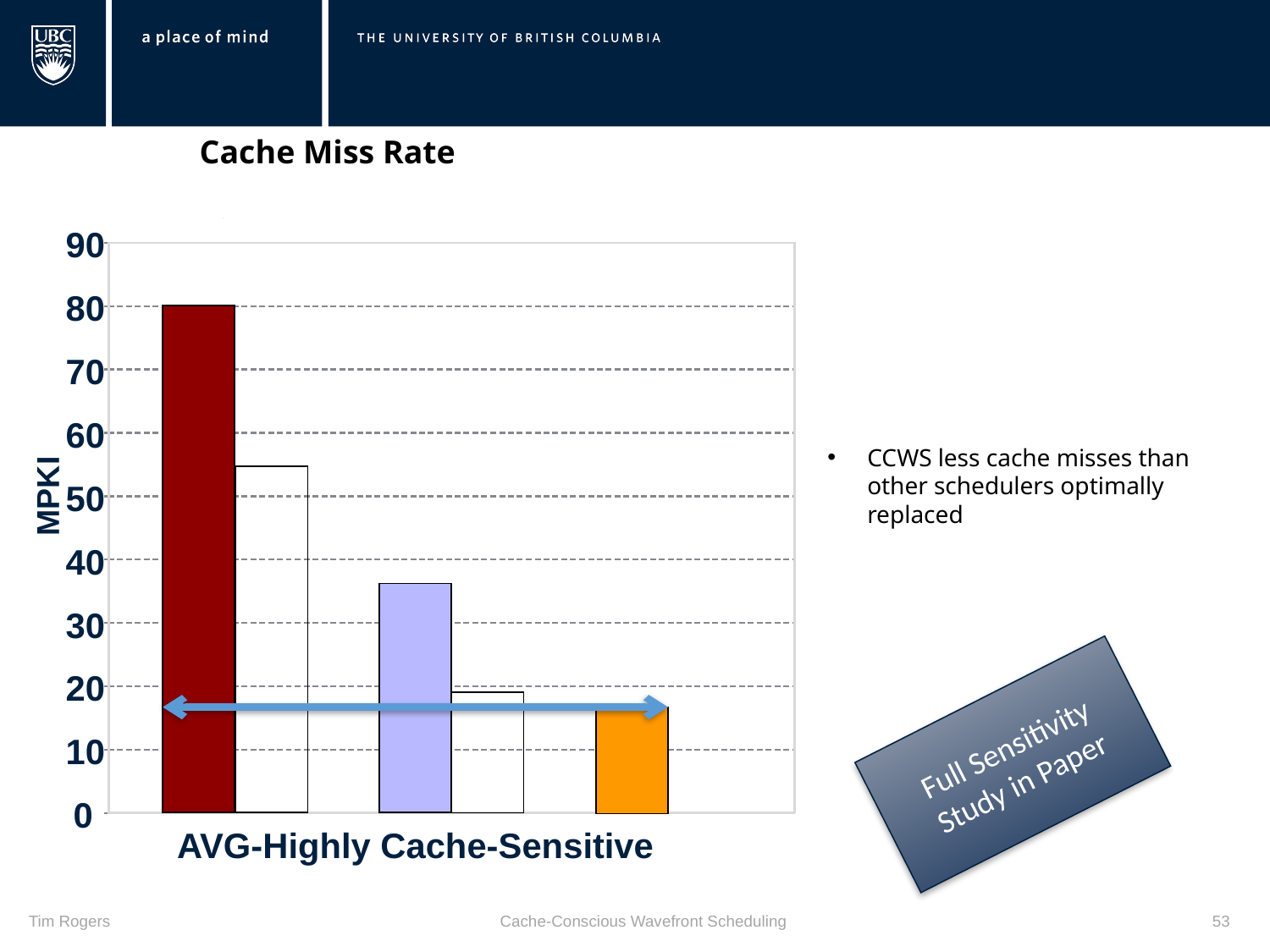
How many categories are shown on the x axis of the chart? 1 Is the value of the first white bar (second from left) greater or less than 50? greater Which bar is the shortest in the chart? the orange bar (rightmost) What is the label on the y axis of the chart? MPKI What kind of chart is shown on the slide? bar chart Is the value of the dark red bar greater or less than 70? greater Is the value of the light blue bar greater or less than 40? less What is the category label on the x axis of the chart? AVG-Highly Cache-Sensitive What is the title of the chart? Cache Miss Rate Which is larger, the light blue bar or the dark red bar? the dark red bar Which bar is the tallest in the chart? the dark red bar (leftmost)